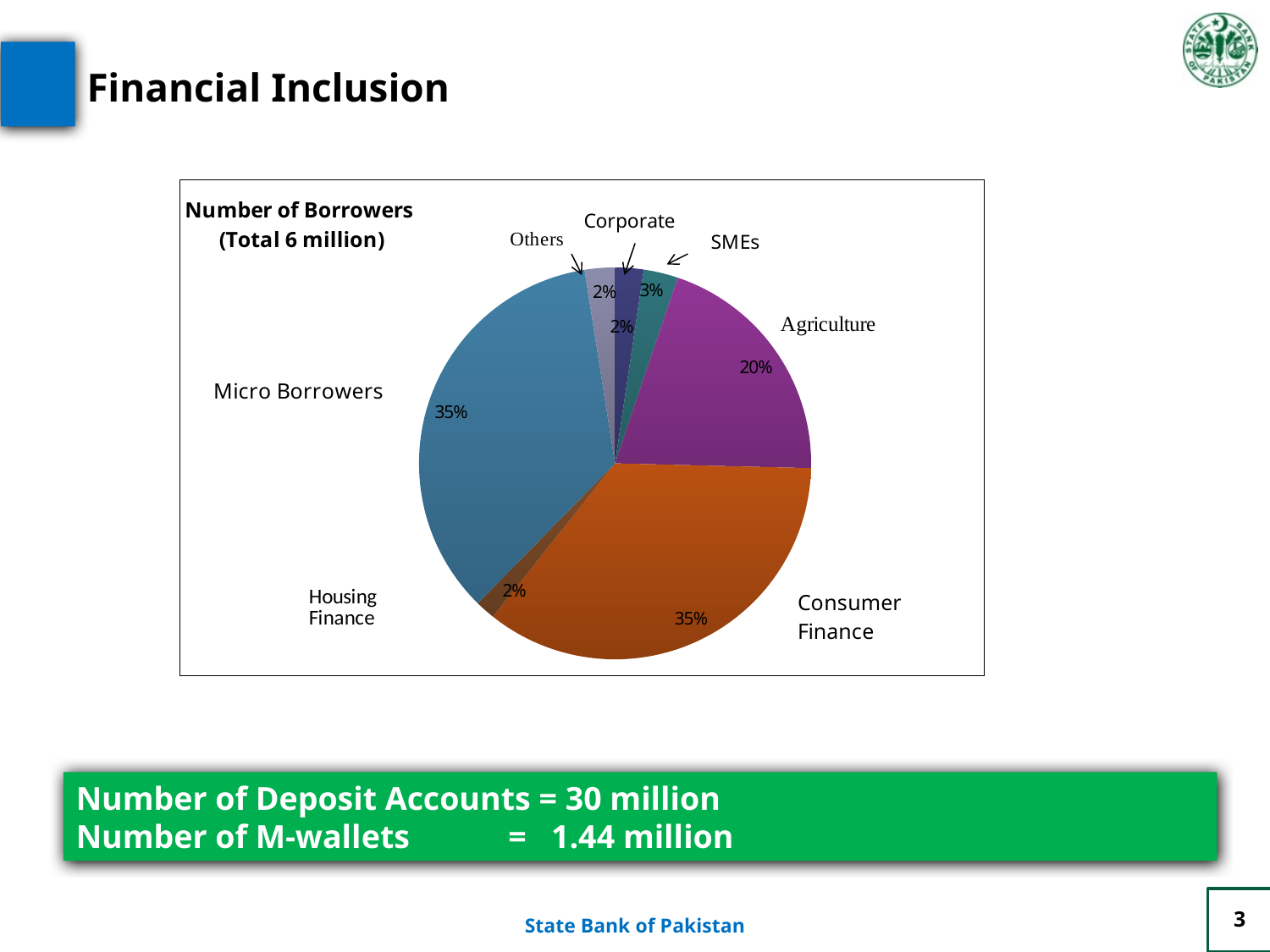
What percentage of borrowers are Micro Borrowers? 35% What kind of chart is shown on the slide? Pie chart What percentage of borrowers is Consumer Finance? 35% What percentage of borrowers is SMEs? 3% Which is larger, the share for Consumer Finance or the share for Agriculture? Consumer Finance What is the title of the chart? Number of Borrowers (Total 6 million) Which is larger, the share for Agriculture or the share for SMEs? Agriculture How many categories are shown in the pie chart? 7 What share of borrowers is Agriculture in the Number of Borrowers pie chart? 20% What percentage of borrowers is Housing Finance? 2% What is the difference in percentage points between the Agriculture share and the SMEs share? 17 percentage points What percentage of borrowers is Corporate? 2%